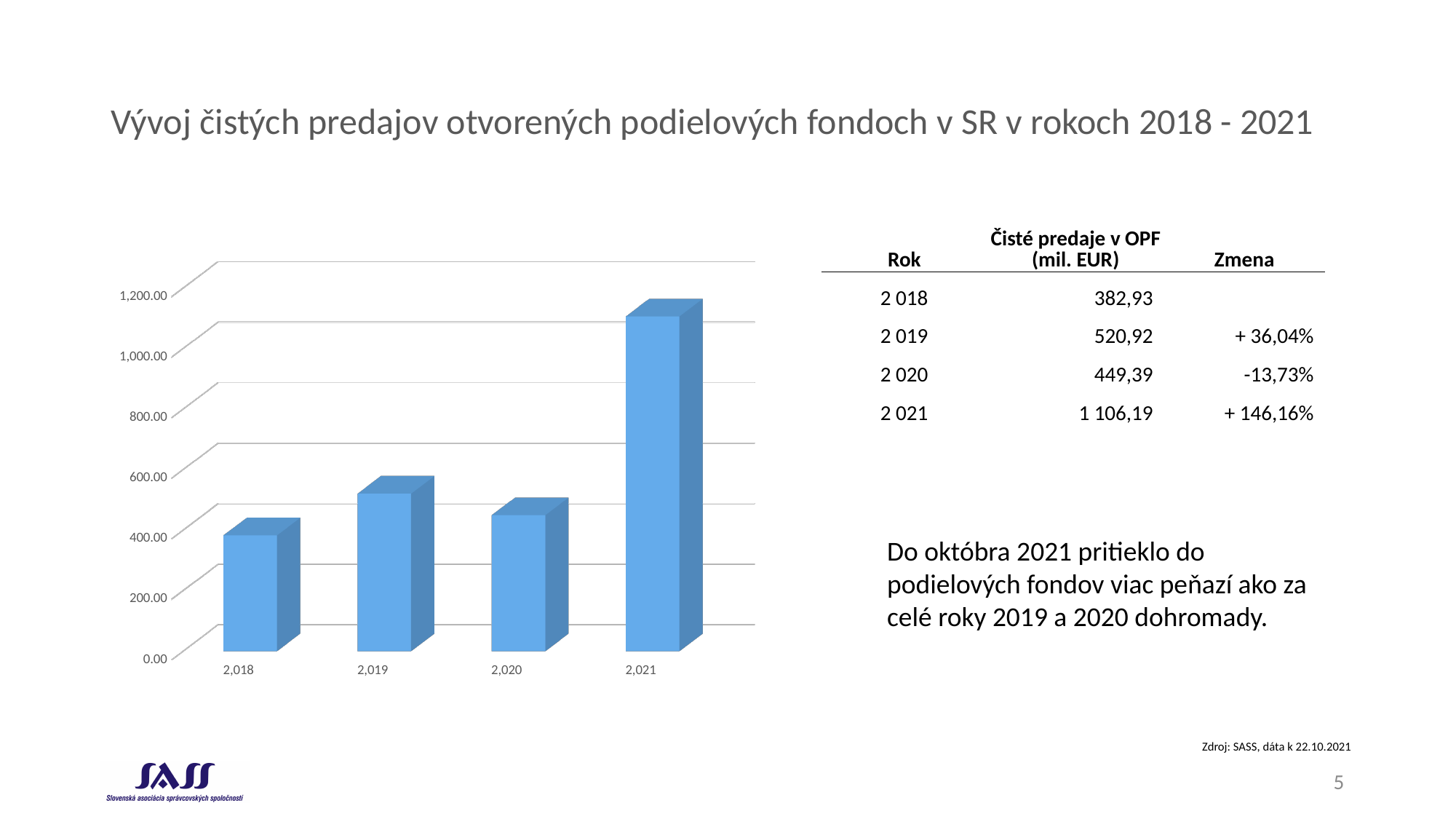
Is the value for 2019 in the chart greater or less than 600.00? less Is the value for 2021 in the chart greater or less than 1,000.00? greater According to the table on the slide, what were the net sales (Čisté predaje v OPF) in 2021 in mil. EUR? 1 106,19 How many years (bars) does the chart show? 4 Which year has the lowest bar in the chart? 2018 Which is larger in the chart, the bar for 2019 or the bar for 2020? 2019 Is the value for 2018 in the chart greater or less than 400.00? less Which year has the highest bar in the chart? 2021 According to the table on the slide, what was the change (Zmena) for 2020? -13,73% What kind of chart is shown on the slide? bar chart What is the highest value shown on the chart's vertical axis? 1,200.00